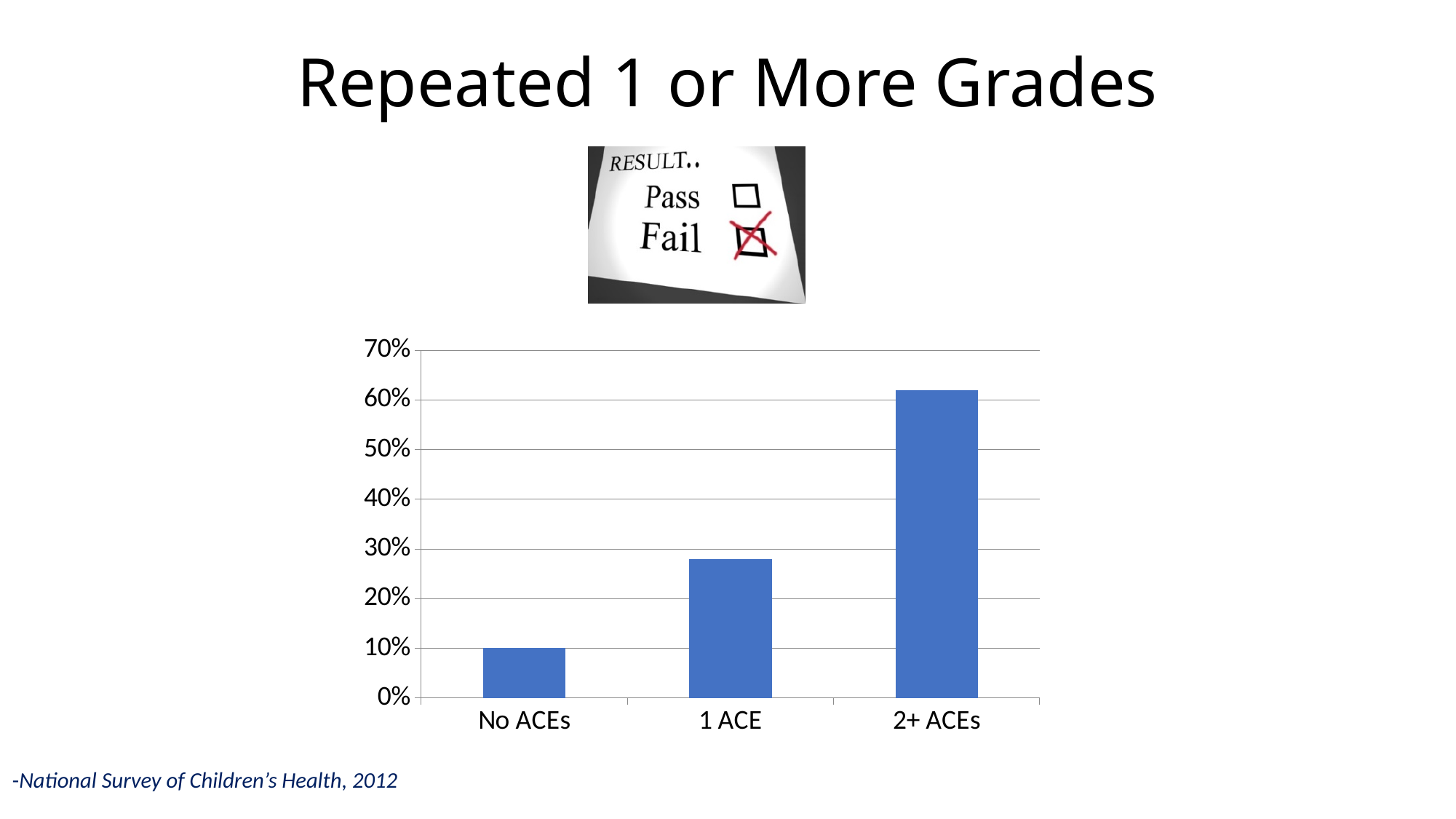
What kind of chart is shown on the slide? bar chart What is the value for No ACEs in the chart? 10% Which category has the lowest value in the chart? No ACEs Is the value for 1 ACE greater or less than 20%? greater Is the value for 2+ ACEs greater or less than 70%? less Which category has the highest value in the chart? 2+ ACEs Is the value for 2+ ACEs greater or less than 50%? greater Do the values rise or fall moving from No ACEs to 2+ ACEs along the x axis? rise How many categories are shown on the x axis of the chart? 3 What is the title of the slide containing the chart? Repeated 1 or More Grades Which is larger, the value for 1 ACE or the value for 2+ ACEs? 2+ ACEs